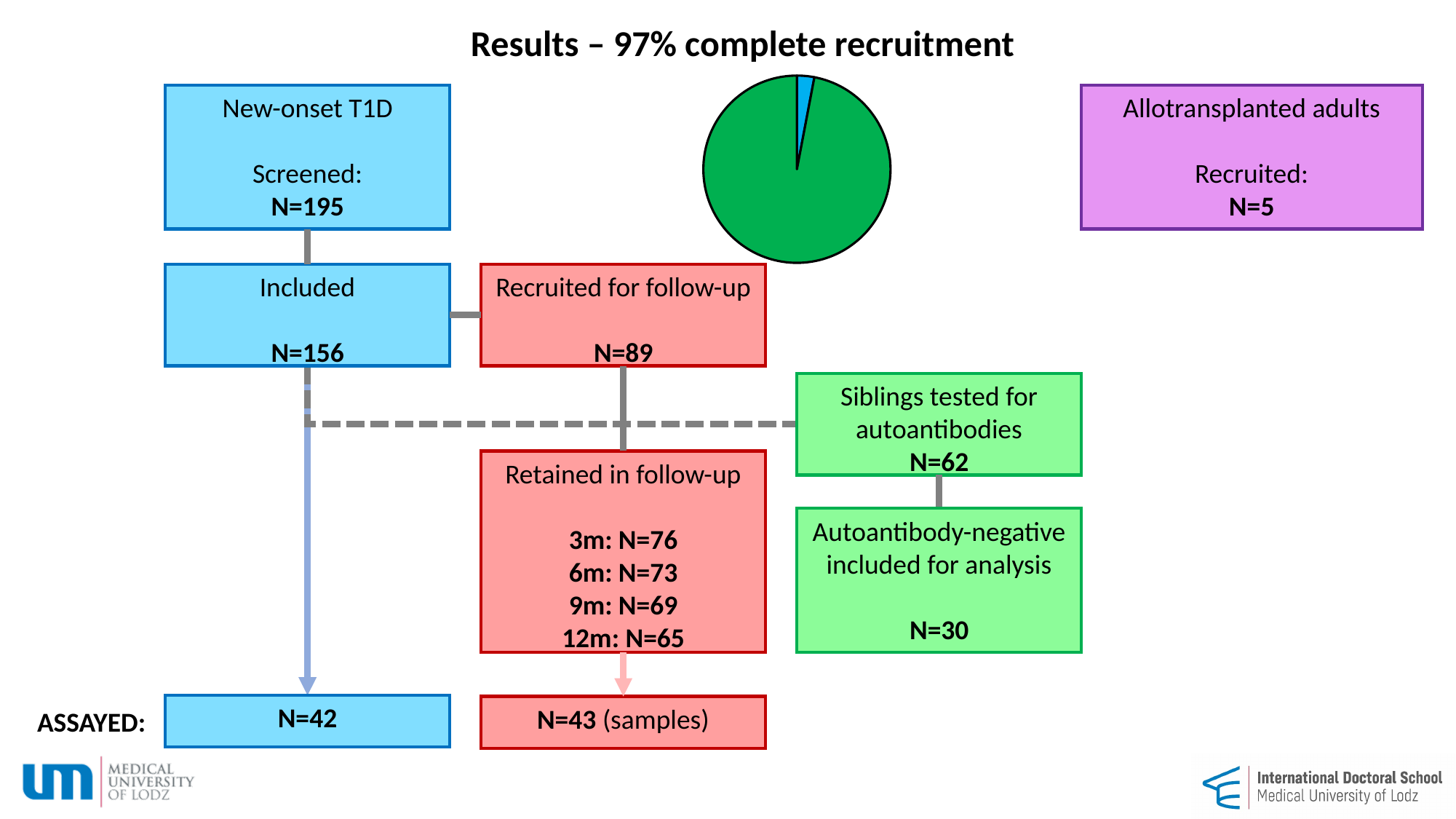
What kind of chart is shown on the slide? pie chart According to the slide title, what percentage of recruitment is complete? 97% Does the pie chart have a legend? No Which colour is the largest slice of the pie chart? green How many slices does the pie chart have? 2 Which slice of the pie chart is larger, the green one or the blue one? green Which colour is the smallest slice of the pie chart? blue